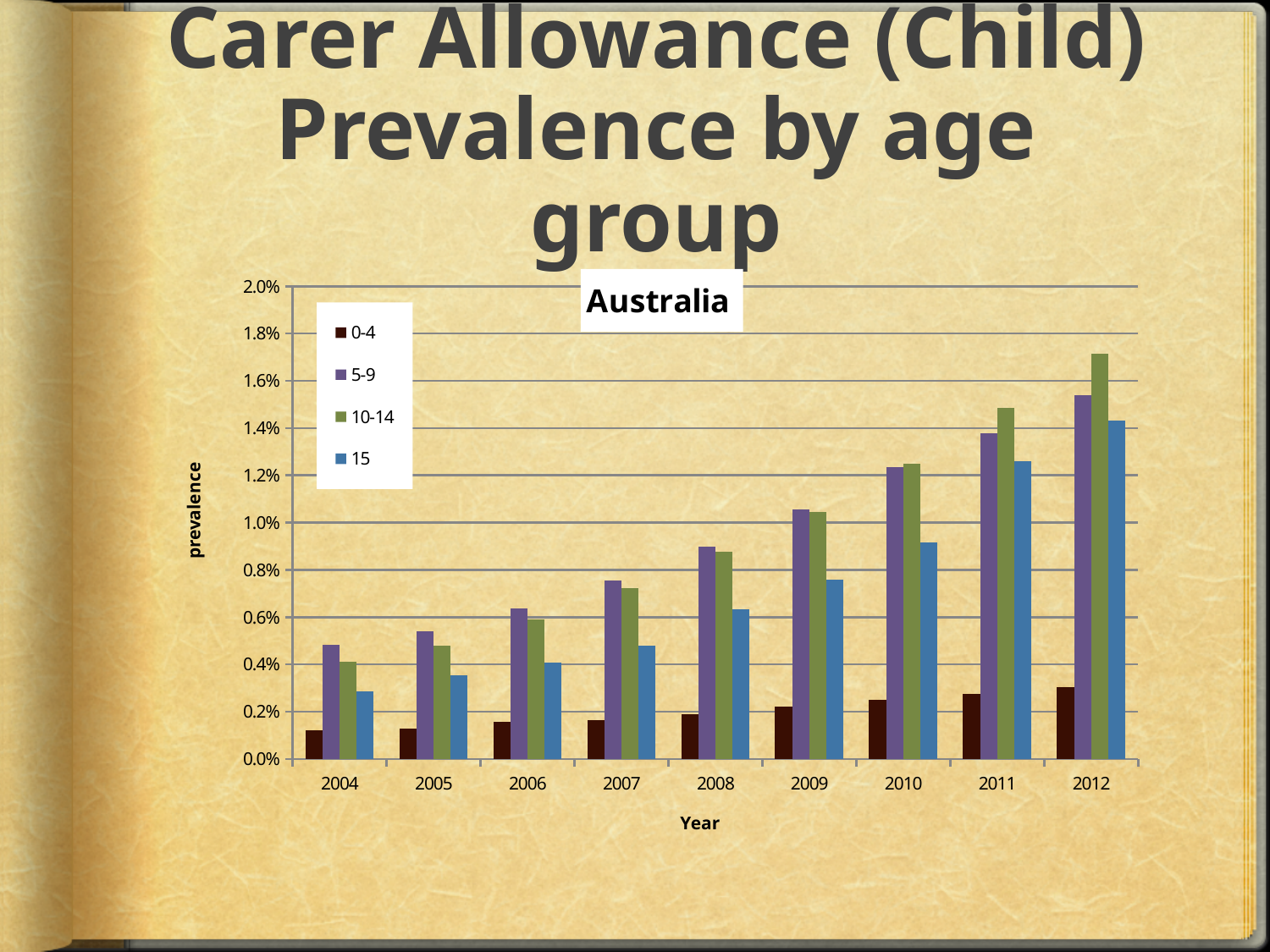
Is the prevalence for the 0-4 age group in 2012 greater or less than 0.4%? less Is the prevalence for the 10-14 age group in 2012 greater or less than 1.6%? greater Does the prevalence for the 10-14 age group rise or fall from 2004 to 2012? rise What is the title shown inside the chart area? Australia In 2008, which has the larger prevalence, the 5-9 age group or the 15 age group? 5-9 How many age groups does the legend list? 4 Which age group has the lowest prevalence in every year shown? 0-4 What kind of chart is shown on the slide? bar chart What is the label on the vertical axis of the chart? prevalence Which age group has the highest prevalence in 2012? 10-14 How many years are shown along the x axis of the chart? 9 In which year is the prevalence for the 10-14 age group highest? 2012